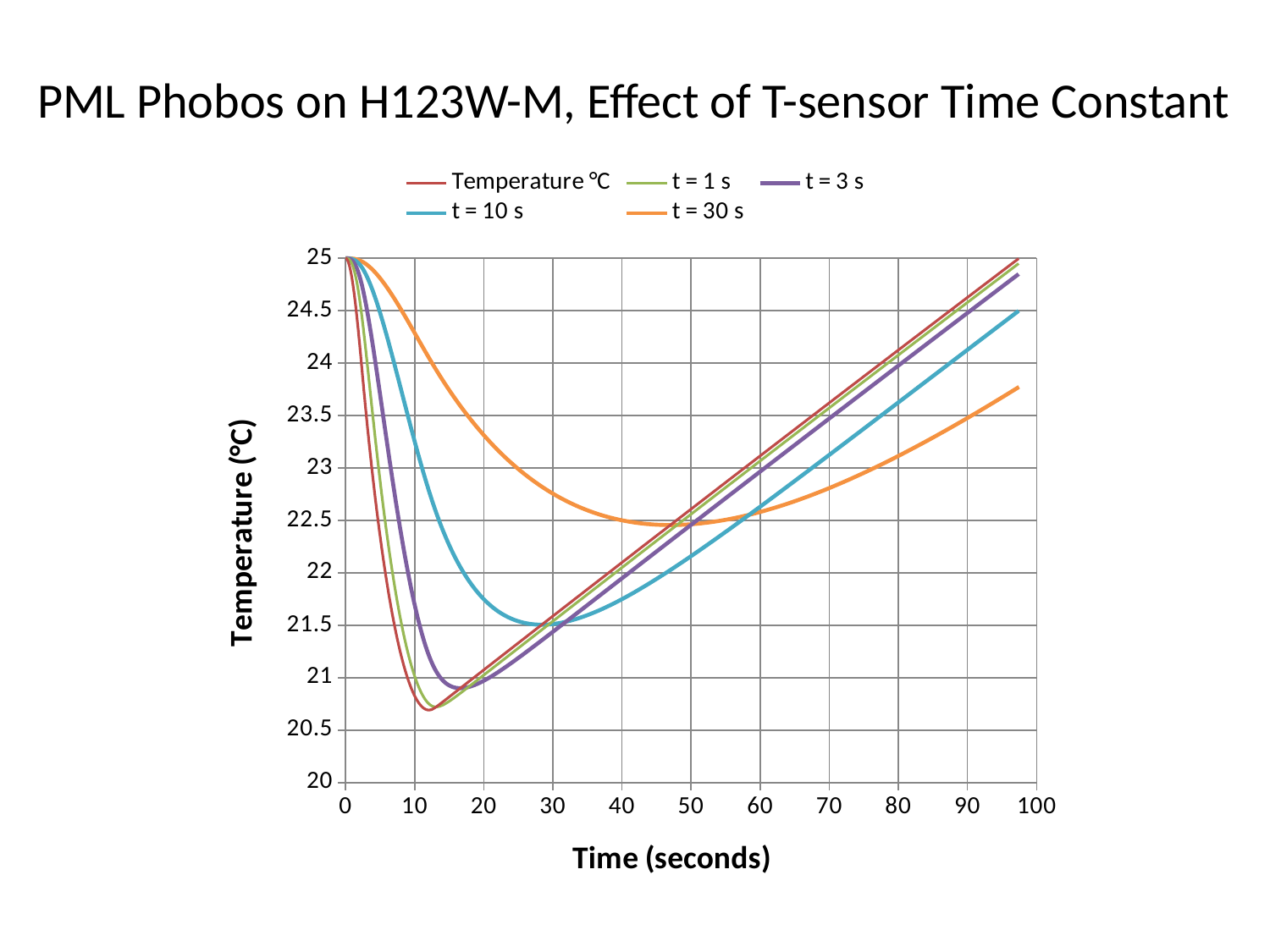
What is the title of the chart? PML Phobos on H123W-M, Effect of T-sensor Time Constant Is the value of the t = 30 s series at 80 seconds greater or less than 23.5? less Which series reaches its minimum temperature latest in time? t = 30 s Does the t = 30 s series rise or fall between 0 and 40 seconds? fall What is the label of the x axis? Time (seconds) What kind of chart is shown on the slide? line chart At 30 seconds, which series has the higher temperature, t = 30 s or t = 10 s? t = 30 s Is the minimum value of the t = 10 s series greater or less than 22? less Which series has the highest minimum temperature? t = 30 s How many series does the legend list? 5 Is the minimum value of the t = 30 s series greater or less than 22? greater What temperature do all the series start at when time is 0 seconds? 25